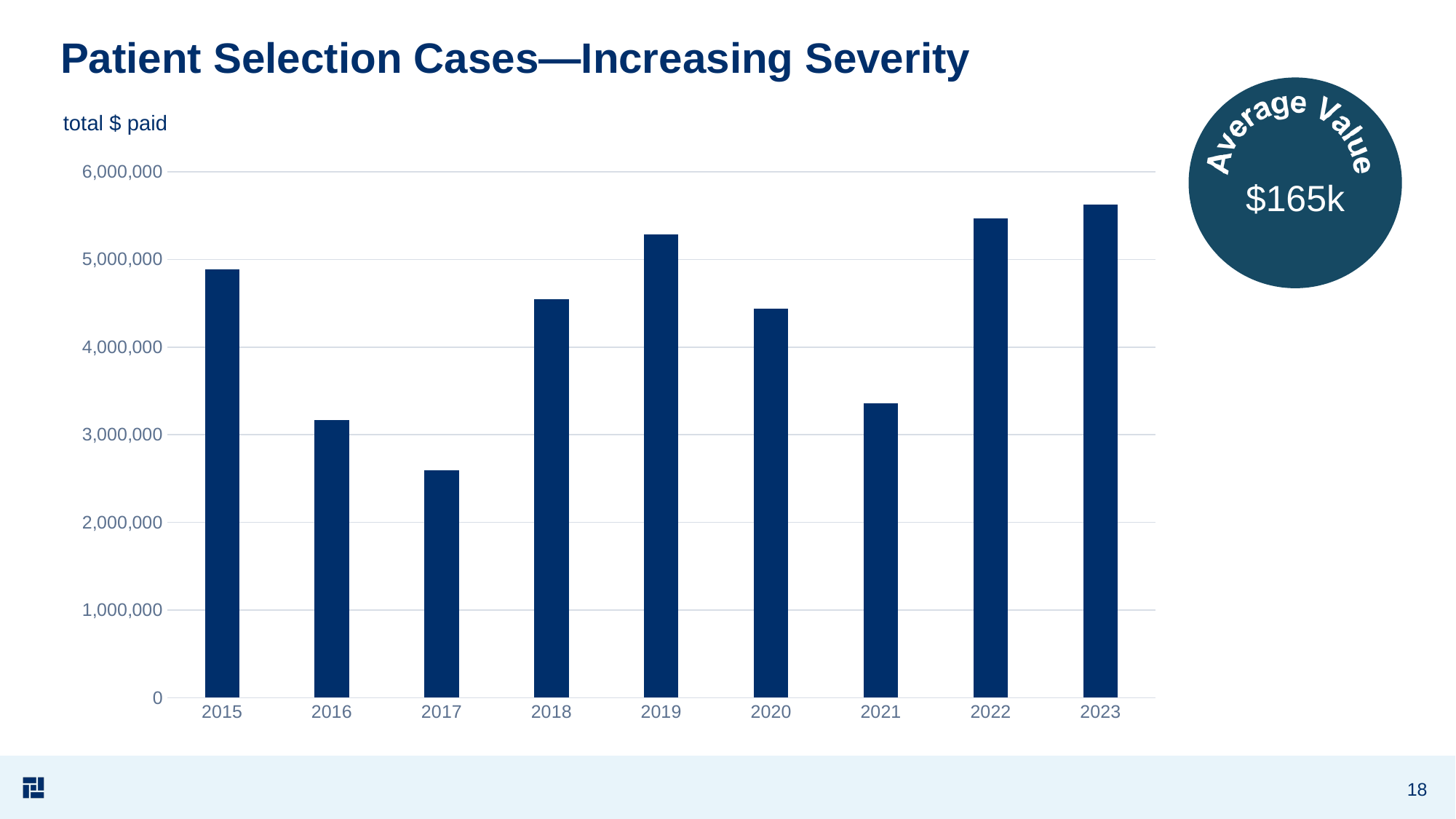
How many years are shown on the x axis of the chart? 9 Which year has the lowest total $ paid? 2017 What kind of chart is shown on the slide? bar chart What average value is shown in the circle next to the chart? $165k Is the value for 2021 greater or less than 4,000,000? less What is the label on the vertical axis of the chart? total $ paid Which year has a larger total $ paid, 2018 or 2016? 2018 Is the value for 2015 greater or less than 4,000,000? greater Is the value for 2017 greater or less than 3,000,000? less Which year has the highest total $ paid? 2023 Which year has a larger total $ paid, 2019 or 2020? 2019